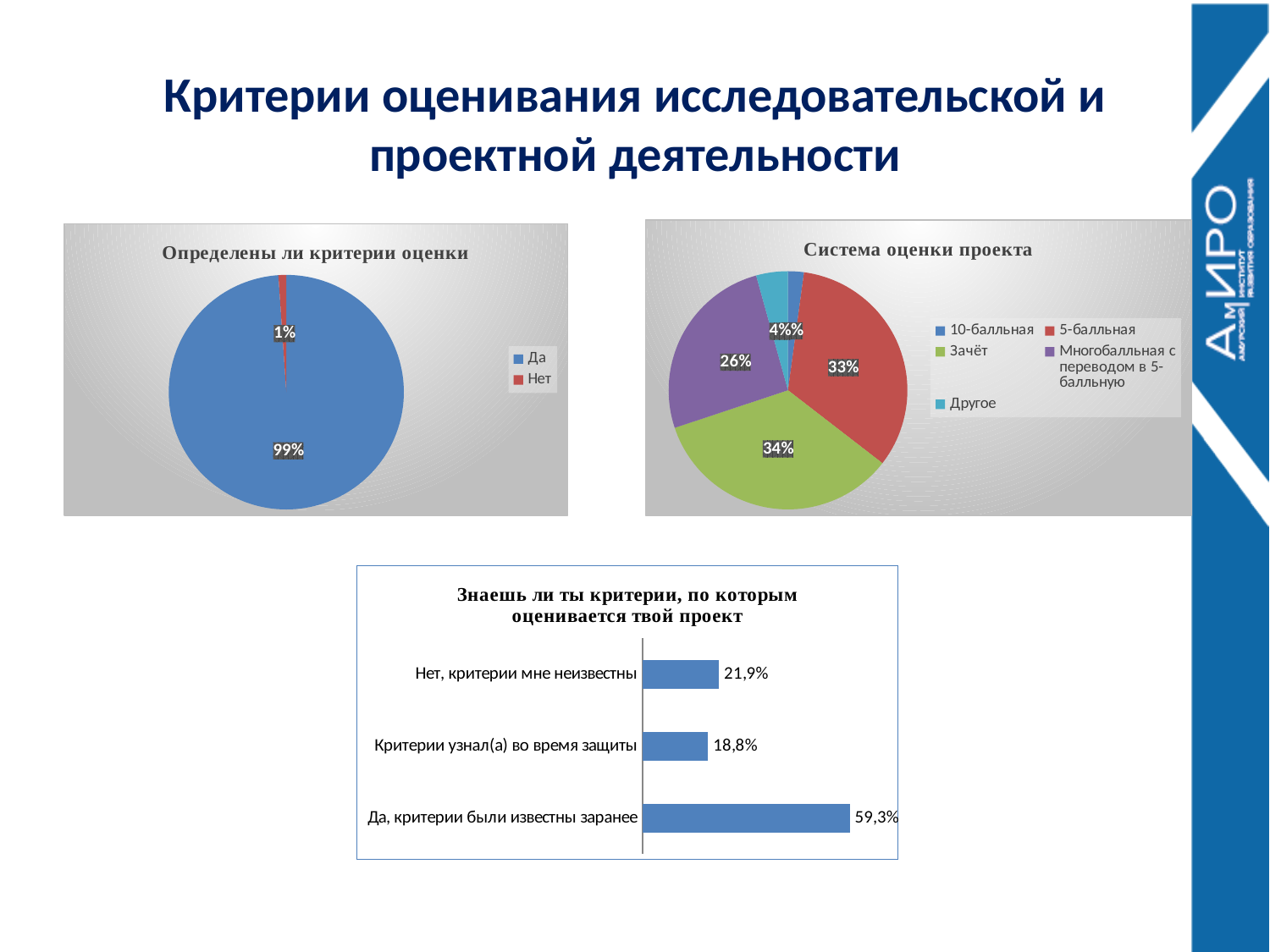
In the chart 'Определены ли критерии оценки', what share of the pie is 'Да'? 99% In the chart 'Система оценки проекта', what share of the pie is 'Зачёт'? 34% In the chart 'Знаешь ли ты критерии, по которым оценивается твой проект', what is the difference between 'Нет, критерии мне неизвестны' and 'Критерии узнал(а) во время защиты'? 3,1% How many entries does the legend of the chart 'Система оценки проекта' list? 5 How many series does the legend of the chart 'Определены ли критерии оценки' list? 2 What kind of chart is 'Знаешь ли ты критерии, по которым оценивается твой проект'? Bar chart In the chart 'Система оценки проекта', what share of the pie is 'Многобалльная с переводом в 5-балльную'? 26% What kind of chart is 'Система оценки проекта'? Pie chart In the chart 'Знаешь ли ты критерии, по которым оценивается твой проект', which category has the lowest value? Критерии узнал(а) во время защиты In the chart 'Знаешь ли ты критерии, по которым оценивается твой проект', what is the value for 'Да, критерии были известны заранее'? 59,3%